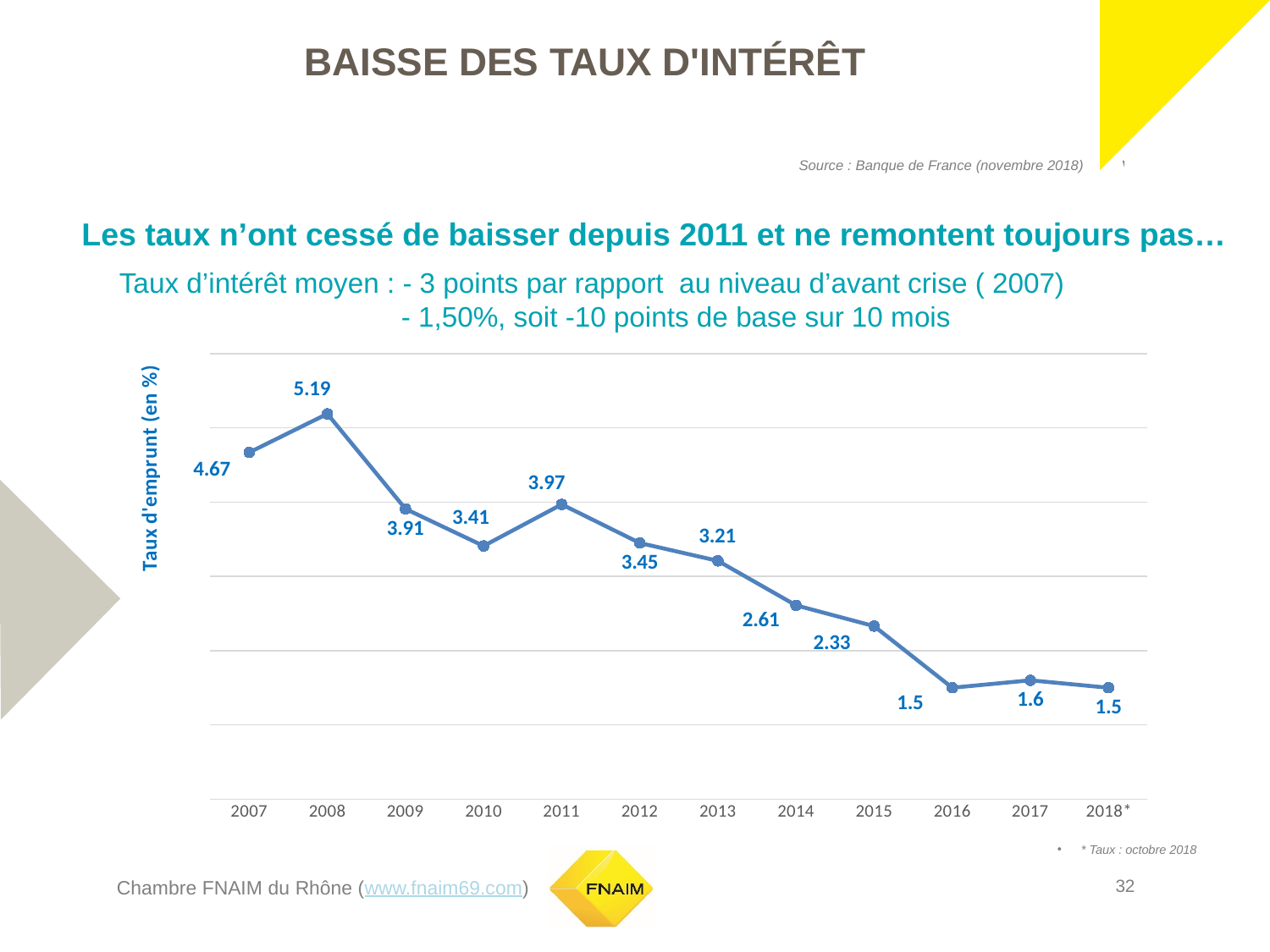
What type of chart is shown on the slide? line chart What is the value for 2008? 5.19 What is the difference between the values for 2007 and 2018*? 3.17 Which year has the highest value? 2008 What is the value for 2013? 3.21 How many years are plotted on the x axis? 12 What is the value for 2015? 2.33 What is the value for 2018*? 1.5 What is the label of the y axis? Taux d'emprunt (en %) Which is larger, the value for 2010 or the value for 2011? 2011 What is the value for 2007? 4.67 What is the lowest value plotted on the chart? 1.5